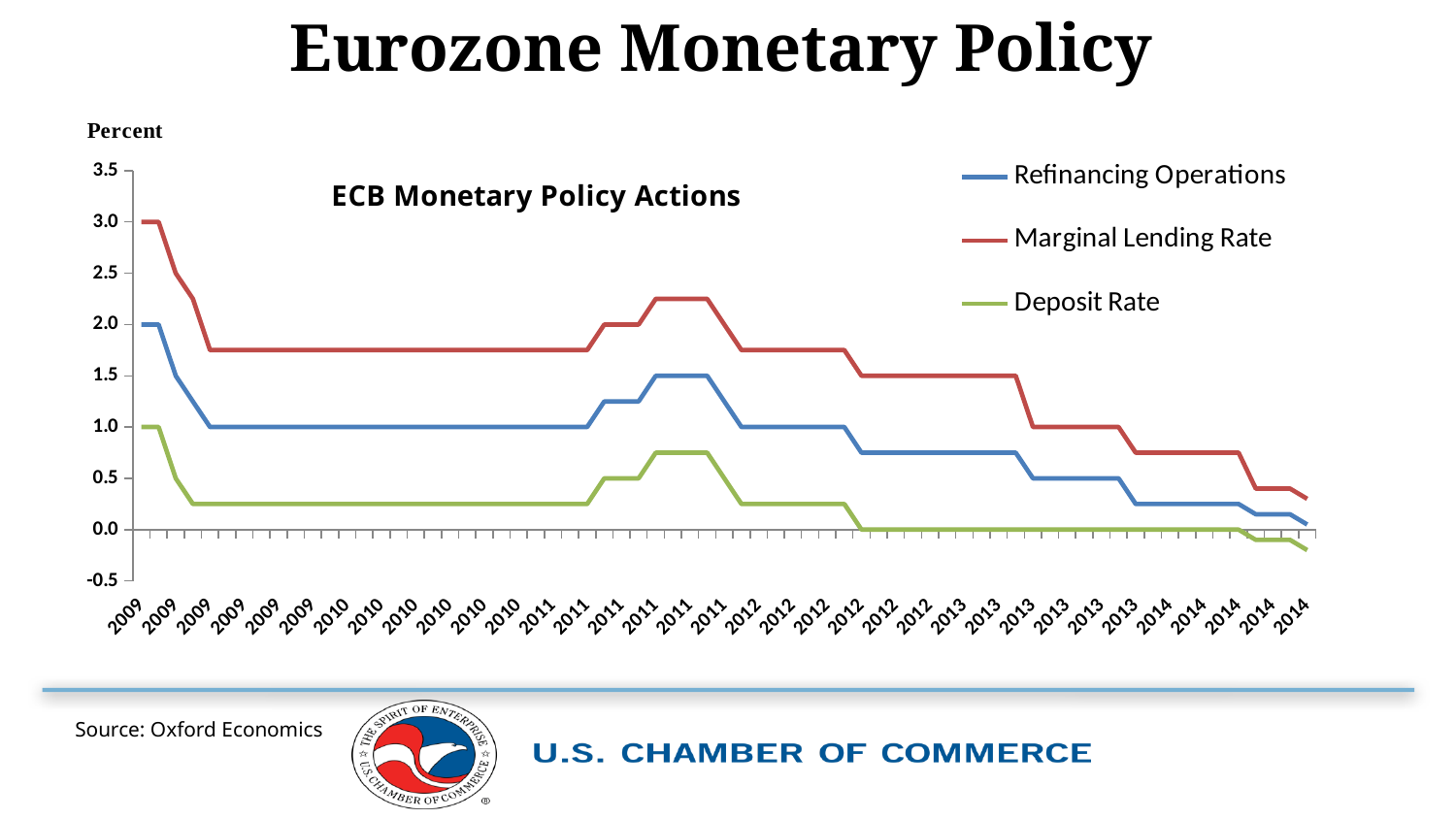
What is the value of the Deposit Rate at the leftmost point (start of 2009)? 1.0 What is the value of the Marginal Lending Rate at the leftmost point (start of 2009)? 3.0 What is the value of Refinancing Operations at the leftmost point (start of 2009)? 2.0 How many series does the legend list? 3 Which series has the highest values across the whole chart? Marginal Lending Rate What is the title printed inside the chart area? ECB Monetary Policy Actions What is the value of Refinancing Operations during 2010? 1.0 Is the value of the Marginal Lending Rate at the rightmost point (end of 2014) greater or less than 0.5? less What unit label is shown above the y axis? Percent What type of chart is shown on the slide? line chart What is the value of the Deposit Rate during 2013? 0.0 Does the Refinancing Operations line rise or fall overall from left to right? fall